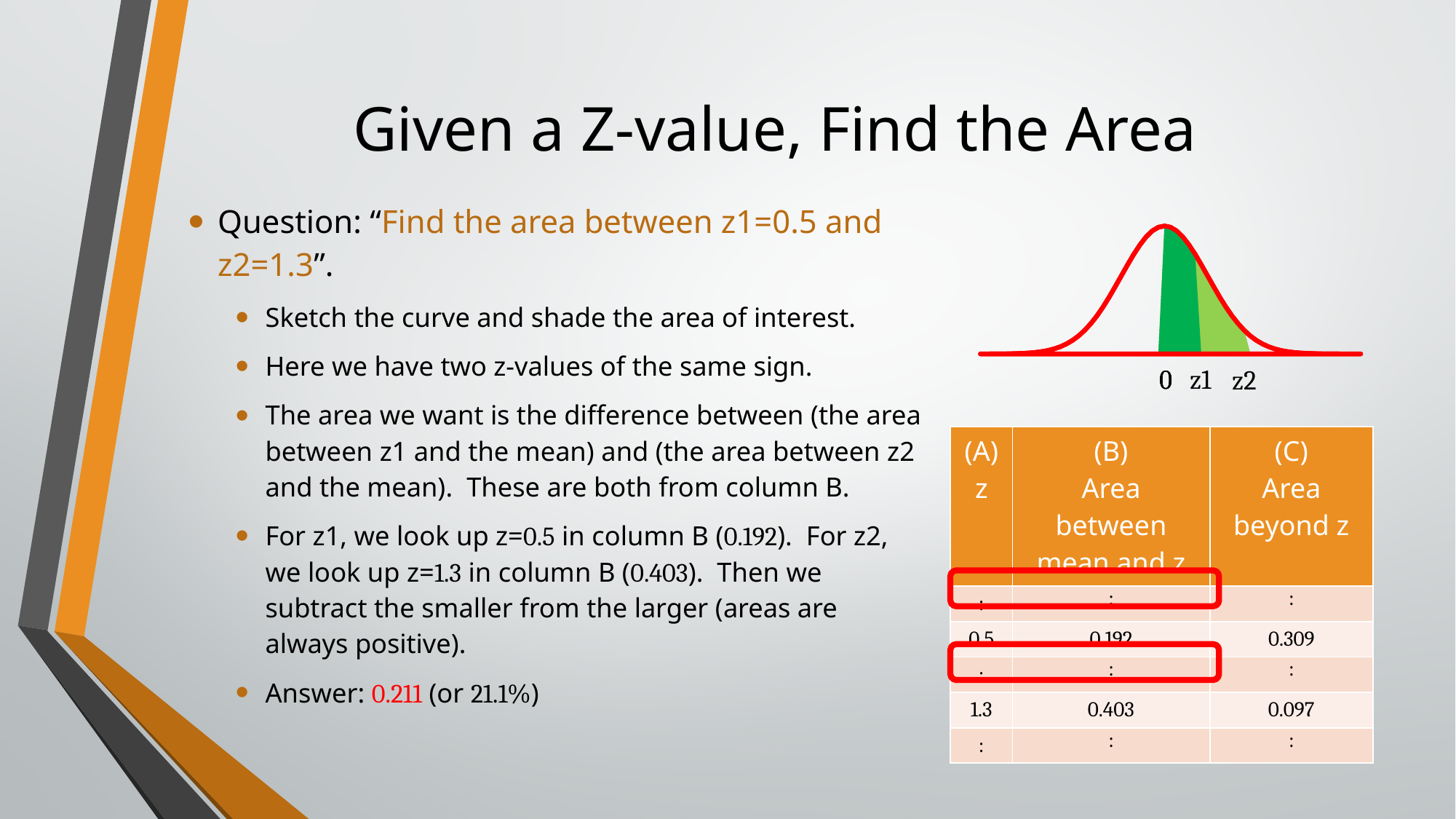
What colour is the curve line in the diagram? Red How many shaded regions are there under the curve in the diagram? 2 What labels appear along the x axis of the curve diagram, from left to right? 0, z1, z2 What kind of chart is shown at the top right of the slide? An area chart (a bell-shaped normal curve with shaded regions under it) How many labels are printed along the x axis of the curve diagram? 3 In the curve diagram, is the shaded region between 0 and z1 darker or lighter green than the region between z1 and z2? Darker